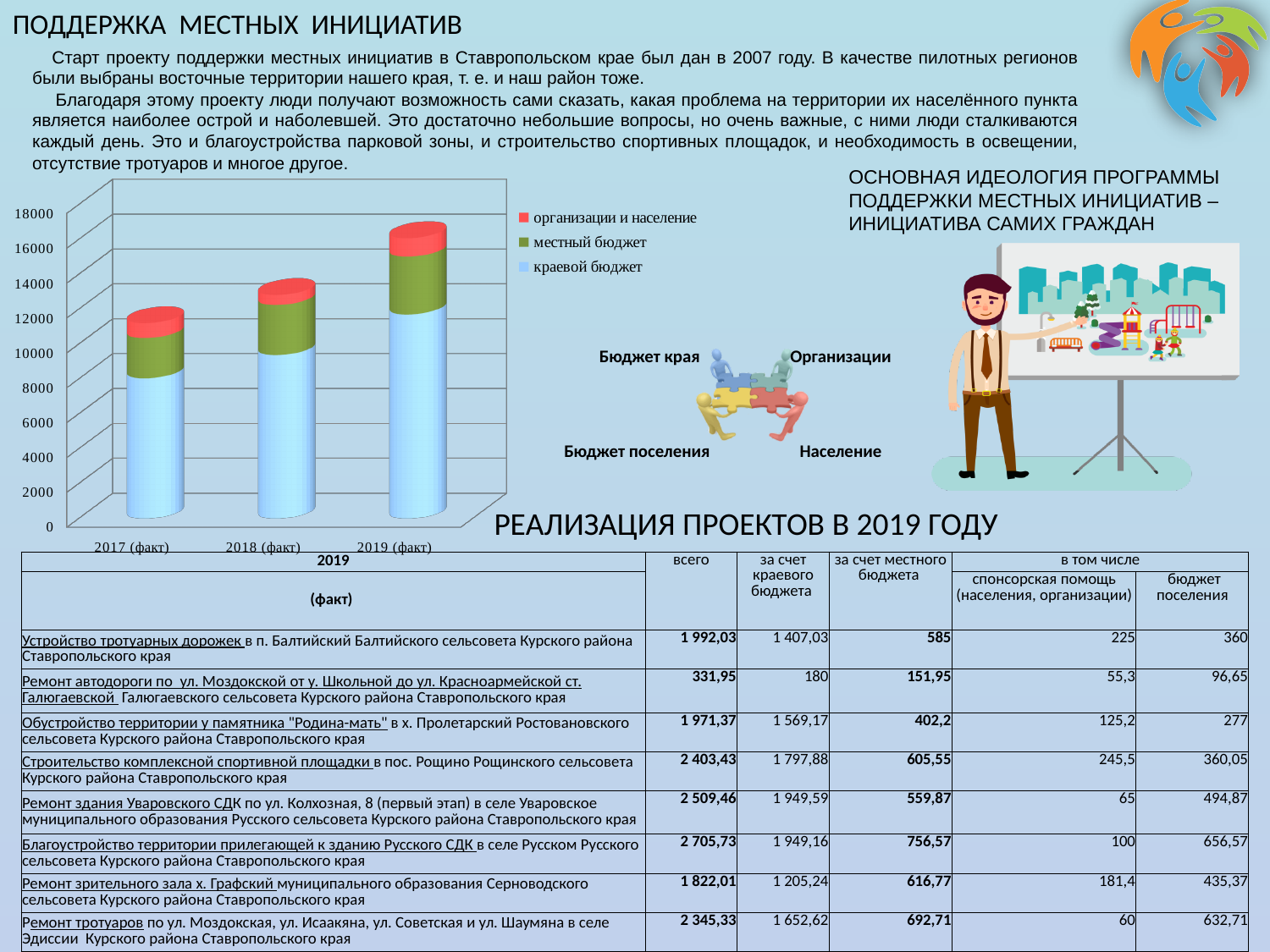
Which series is shown in red in the chart legend? организации и население What kind of chart is shown on the slide? stacked bar chart How many series does the chart legend list? 3 Is the краевой бюджет segment for 2017 (факт) greater or less than 10000? less Which year has the tallest stacked bar in the chart? 2019 (факт) Do the total bar heights rise or fall from 2017 to 2019? rise Is the total stacked value for 2017 (факт) greater or less than 14000? less Which series forms the largest segment in every bar of the chart? краевой бюджет How many categories (years) are plotted on the x axis of the chart? 3 Which year has the shortest stacked bar in the chart? 2017 (факт) Which is larger, the total bar for 2019 (факт) or the total bar for 2017 (факт)? 2019 (факт) Is the total stacked value for 2019 (факт) greater or less than 14000? greater